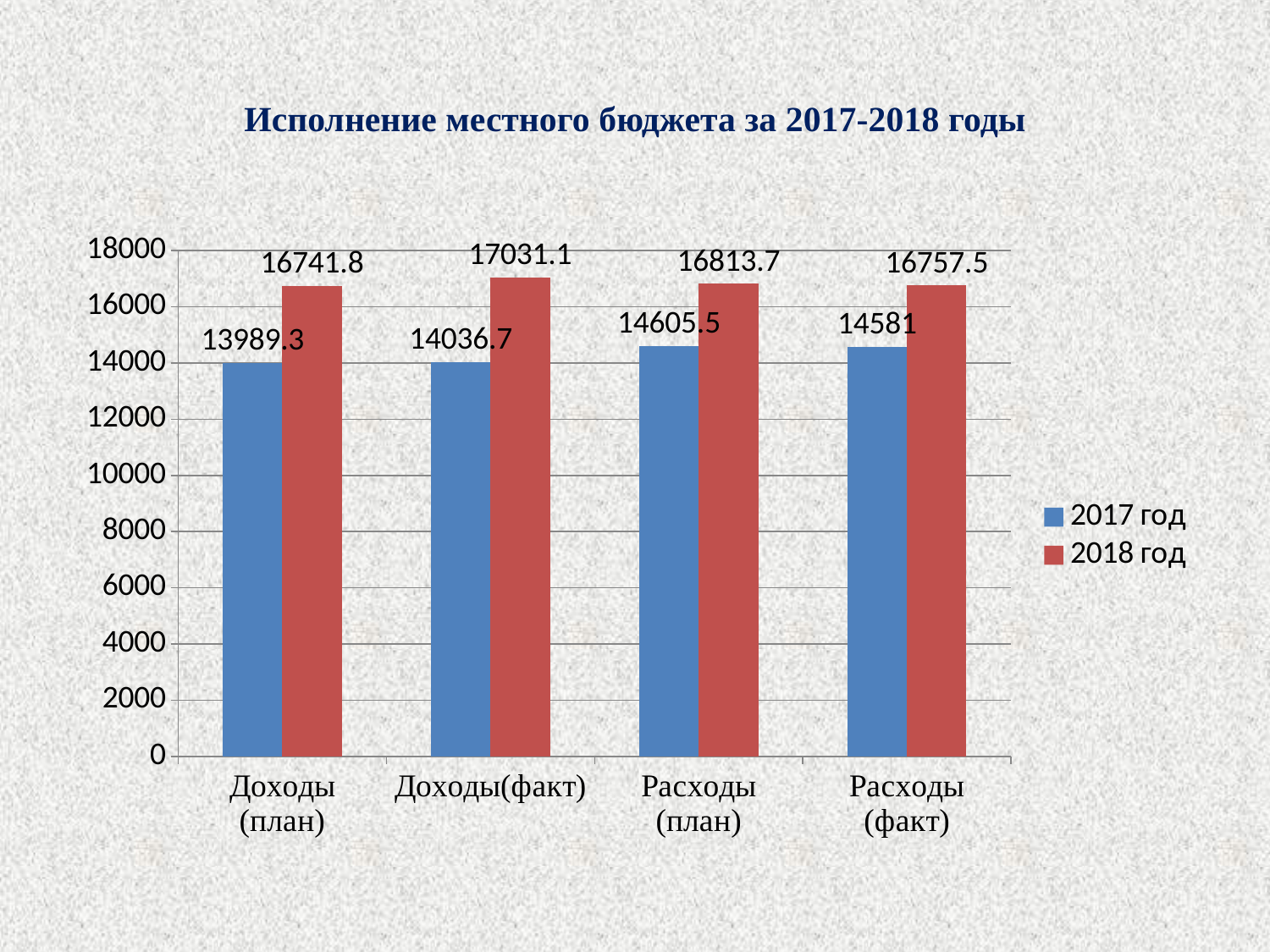
What is the value for Расходы (план) in the 2018 год series? 16813.7 Is the 2017 год value for Расходы (факт) greater or less than 16000? less What is the value for Доходы (план) in the 2017 год series? 13989.3 Which category has the lowest value in the 2017 год series? Доходы (план) What is the value for Доходы(факт) in the 2018 год series? 17031.1 What is the value for Расходы (факт) in the 2017 год series? 14581 How many series does the legend list? 2 Which is larger for Расходы (план): the 2017 год value or the 2018 год value? 2018 год What type of chart is shown on the slide? Bar chart What is the difference between the 2018 год and 2017 год values for Доходы(факт)? 2994.4 Which category has the highest value in the 2018 год series? Доходы(факт) How many categories are shown on the x axis? 4